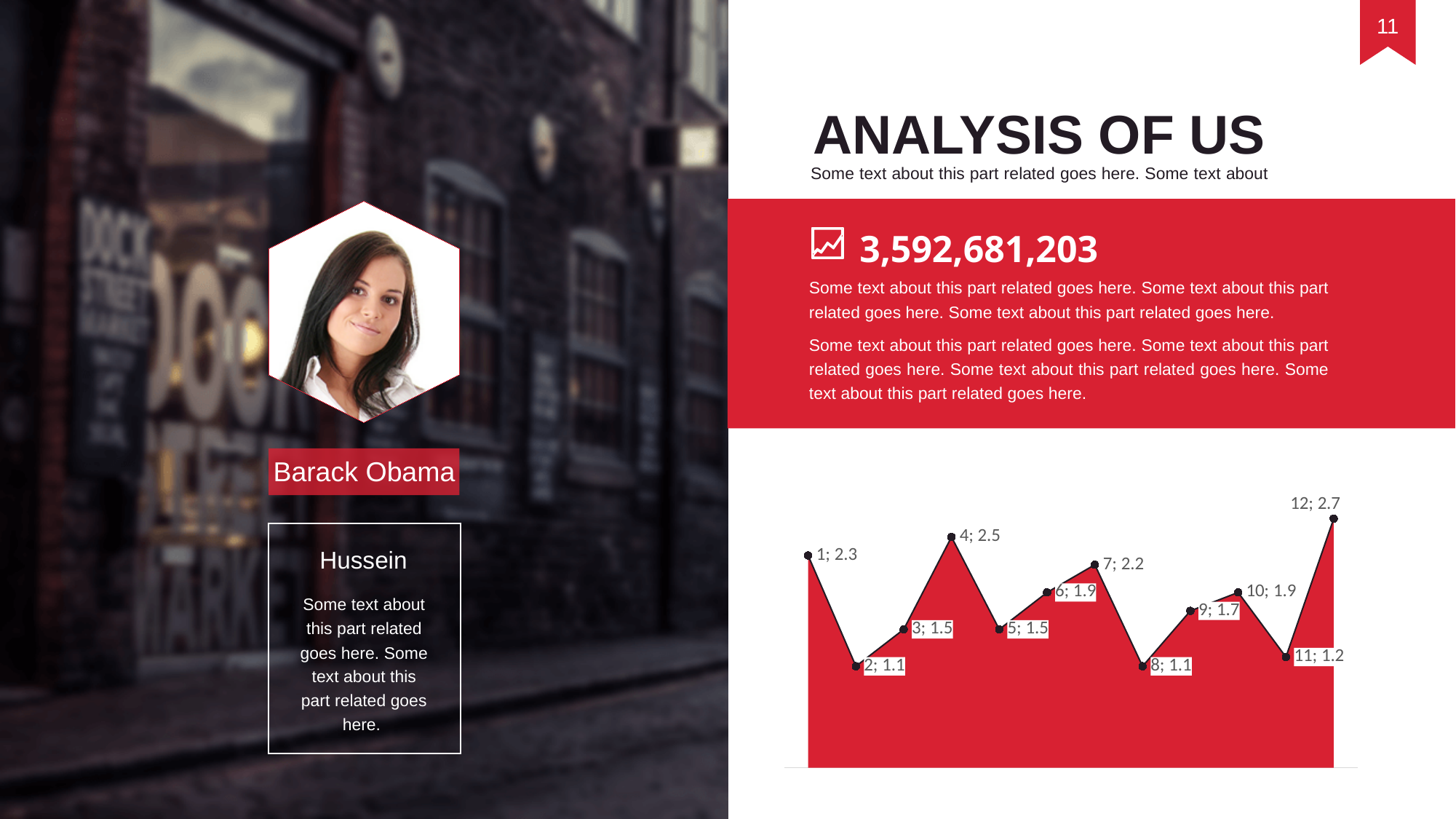
What is the value at point 11 on the chart? 1.2 What is the difference between the values at point 4 and point 3? 1 Which point has the highest value on the chart? 12 Which is larger, the value at point 6 or the value at point 9? point 6 Does the value rise or fall from point 1 to point 2? fall What is the lowest value plotted on the chart? 1.1 How many data points are plotted on the chart? 12 What is the value at point 4 on the chart? 2.5 What is the difference between the values at point 12 and point 11? 1.5 What is the value at point 1 on the chart? 2.3 What kind of chart is shown on the slide? area chart What is the value at point 7 on the chart? 2.2